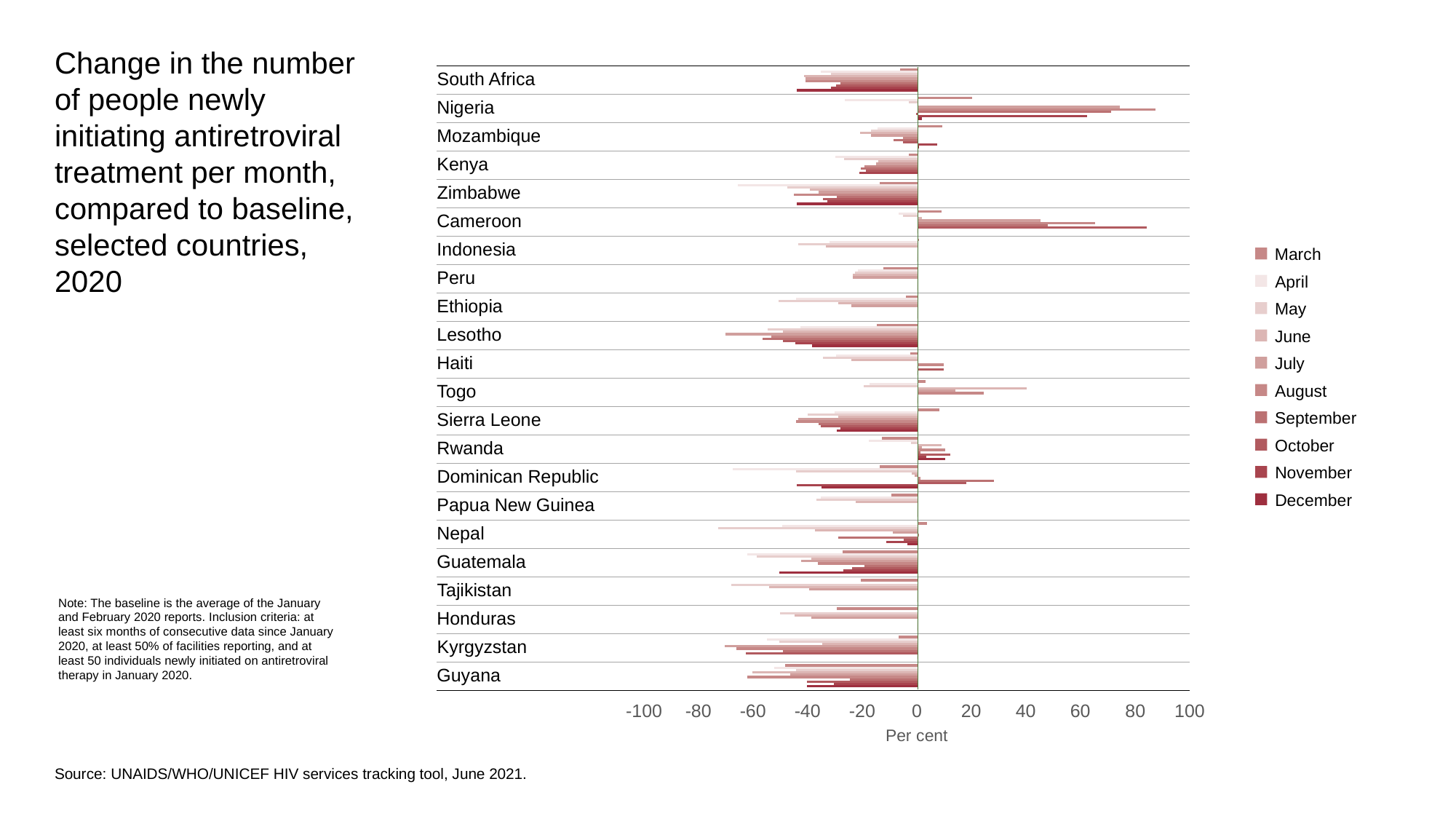
Is the longest positive bar for the Dominican Republic greater or less than 20? greater What is the label of the horizontal axis? Per cent Which month is the first entry in the legend? March Which country has the larger longest positive bar, Nigeria or Togo? Nigeria Is the longest bar for Nigeria greater or less than 80? greater How many series (months) does the legend list? 10 Is the most negative bar for Lesotho greater or less than -60? less What kind of chart is shown on the slide? Bar chart Which country has the more negative longest bar, Lesotho or Peru? Lesotho How many countries are listed on the chart? 22